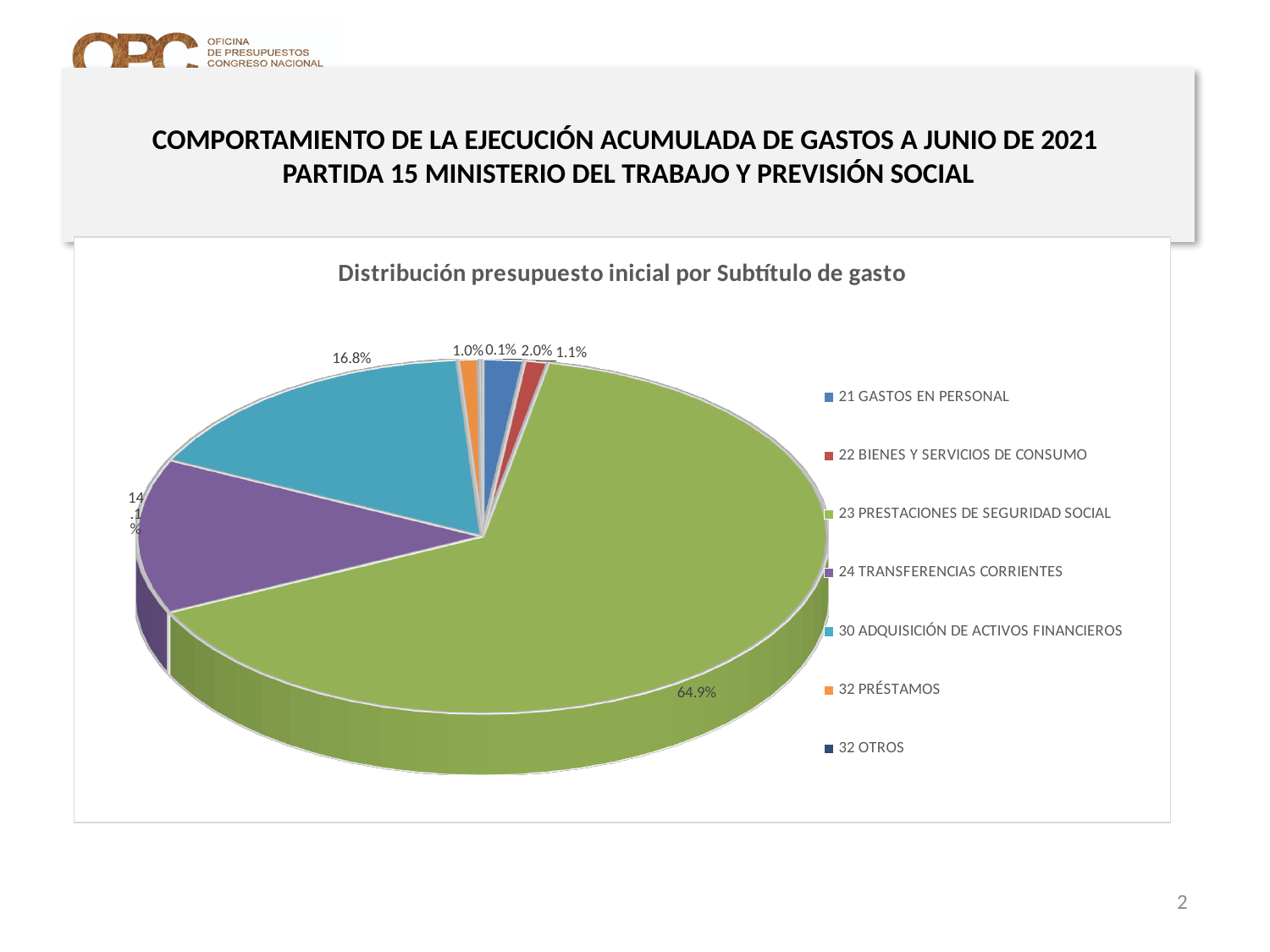
How many categories does the legend list? 7 What is the difference in percentage points between the shares of 30 ADQUISICIÓN DE ACTIVOS FINANCIEROS and 24 TRANSFERENCIAS CORRIENTES? 2.7 What share of the pie is 30 ADQUISICIÓN DE ACTIVOS FINANCIEROS? 16.8% What share of the pie is 21 GASTOS EN PERSONAL? 2.0% Which category has the smallest share of the pie? 32 OTROS What share of the pie is 24 TRANSFERENCIAS CORRIENTES? 14.1% What is the title of the chart? Distribución presupuesto inicial por Subtítulo de gasto Which has a larger share, 30 ADQUISICIÓN DE ACTIVOS FINANCIEROS or 24 TRANSFERENCIAS CORRIENTES? 30 ADQUISICIÓN DE ACTIVOS FINANCIEROS What kind of chart is shown on the slide? Pie chart Which category has the largest share of the pie? 23 PRESTACIONES DE SEGURIDAD SOCIAL